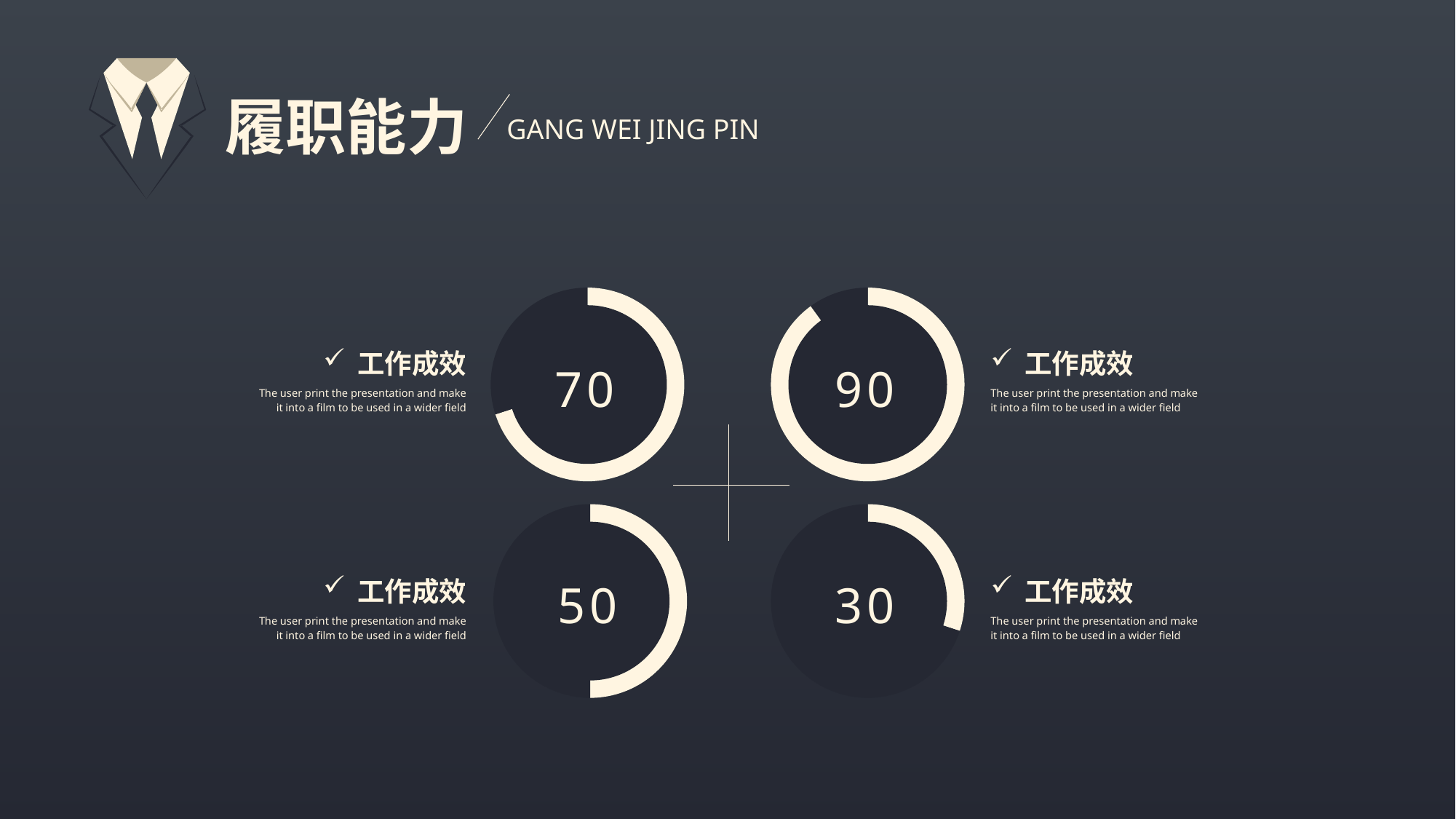
What value is shown in the centre of the top-right ring chart? 90 Which of the four ring charts shows the highest value? top-right (90) Which of the four ring charts shows the lowest value? bottom-right (30) What value is shown in the centre of the bottom-right ring chart? 30 Which is larger, the value in the top-left ring chart or the value in the bottom-left ring chart? top-left (70) What value is shown in the centre of the top-left ring chart? 70 What is the difference between the value in the top-left ring chart and the value in the bottom-left ring chart? 20 What is the difference between the value in the top-right ring chart and the value in the bottom-right ring chart? 60 How many ring charts are shown on the slide? 4 What kind of chart is used to display the four values on the slide? ring (doughnut) chart What Chinese label appears next to each of the four ring charts? 工作成效 What value is shown in the centre of the bottom-left ring chart? 50